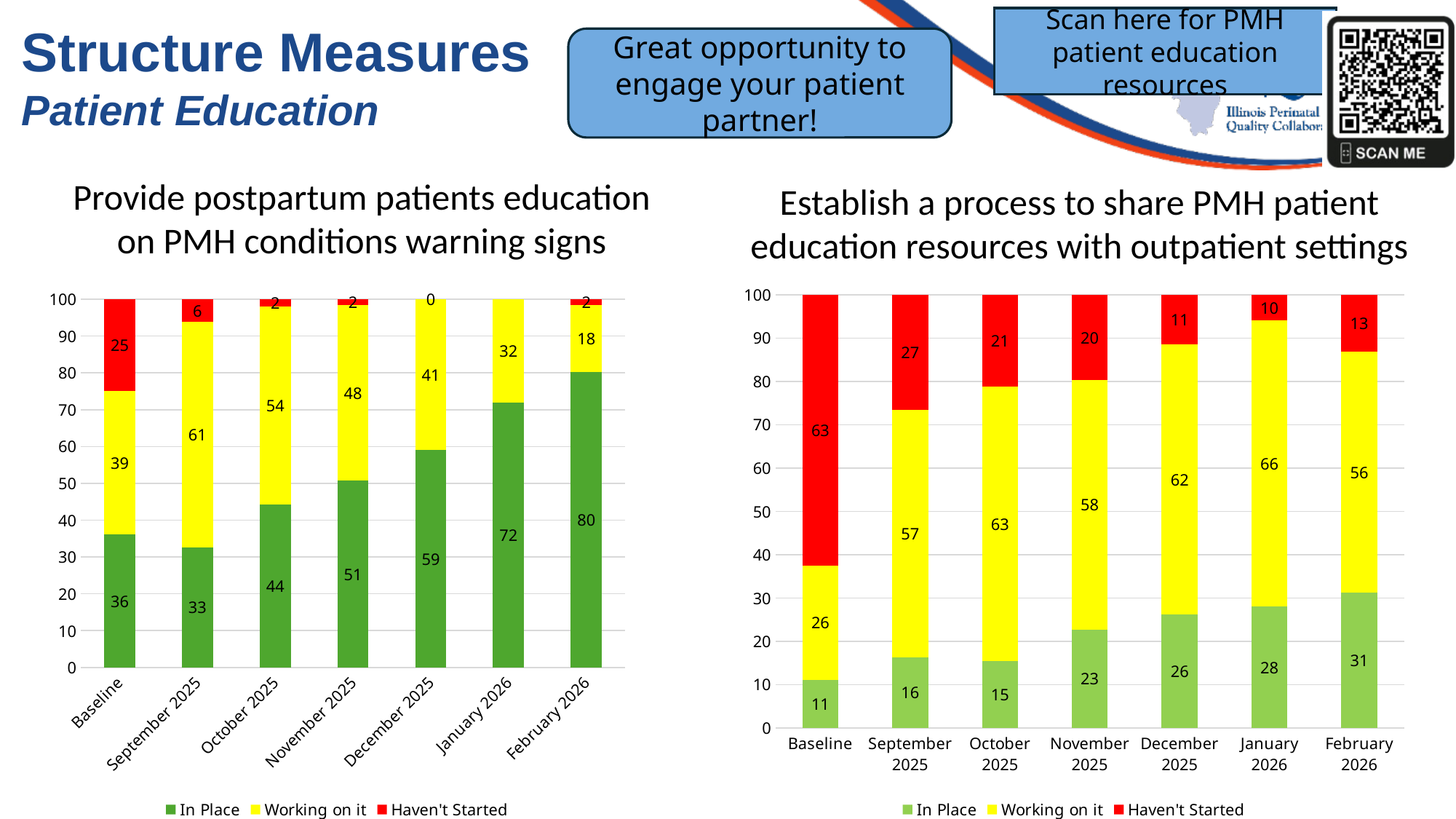
In the left chart (Provide postpartum patients education on PMH conditions warning signs), what is the 'In Place' value for February 2026? 80 How many series does the legend of the left chart (Provide postpartum patients education on PMH conditions warning signs) list? 3 In the left chart (Provide postpartum patients education on PMH conditions warning signs), which category has the lowest 'In Place' value? September 2025 In the right chart (Establish a process to share PMH patient education resources with outpatient settings), which is larger: the 'Haven't Started' value for October 2025 or for December 2025? October 2025 In the left chart (Provide postpartum patients education on PMH conditions warning signs), does the 'In Place' value generally rise or fall from September 2025 to February 2026? rise In the left chart (Provide postpartum patients education on PMH conditions warning signs), which category has the highest 'In Place' value? February 2026 In the left chart (Provide postpartum patients education on PMH conditions warning signs), what is the difference between the 'Working on it' values for September 2025 and February 2026? 43 In the right chart (Establish a process to share PMH patient education resources with outpatient settings), what is the 'Haven't Started' value at Baseline? 63 How many categories are shown on the x axis of the right chart (Establish a process to share PMH patient education resources with outpatient settings)? 7 In the left chart (Provide postpartum patients education on PMH conditions warning signs), what is the 'Haven't Started' value at Baseline? 25 In the right chart (Establish a process to share PMH patient education resources with outpatient settings), what is the 'Working on it' value for January 2026? 66 In the right chart (Establish a process to share PMH patient education resources with outpatient settings), which category has the lowest 'In Place' value? Baseline